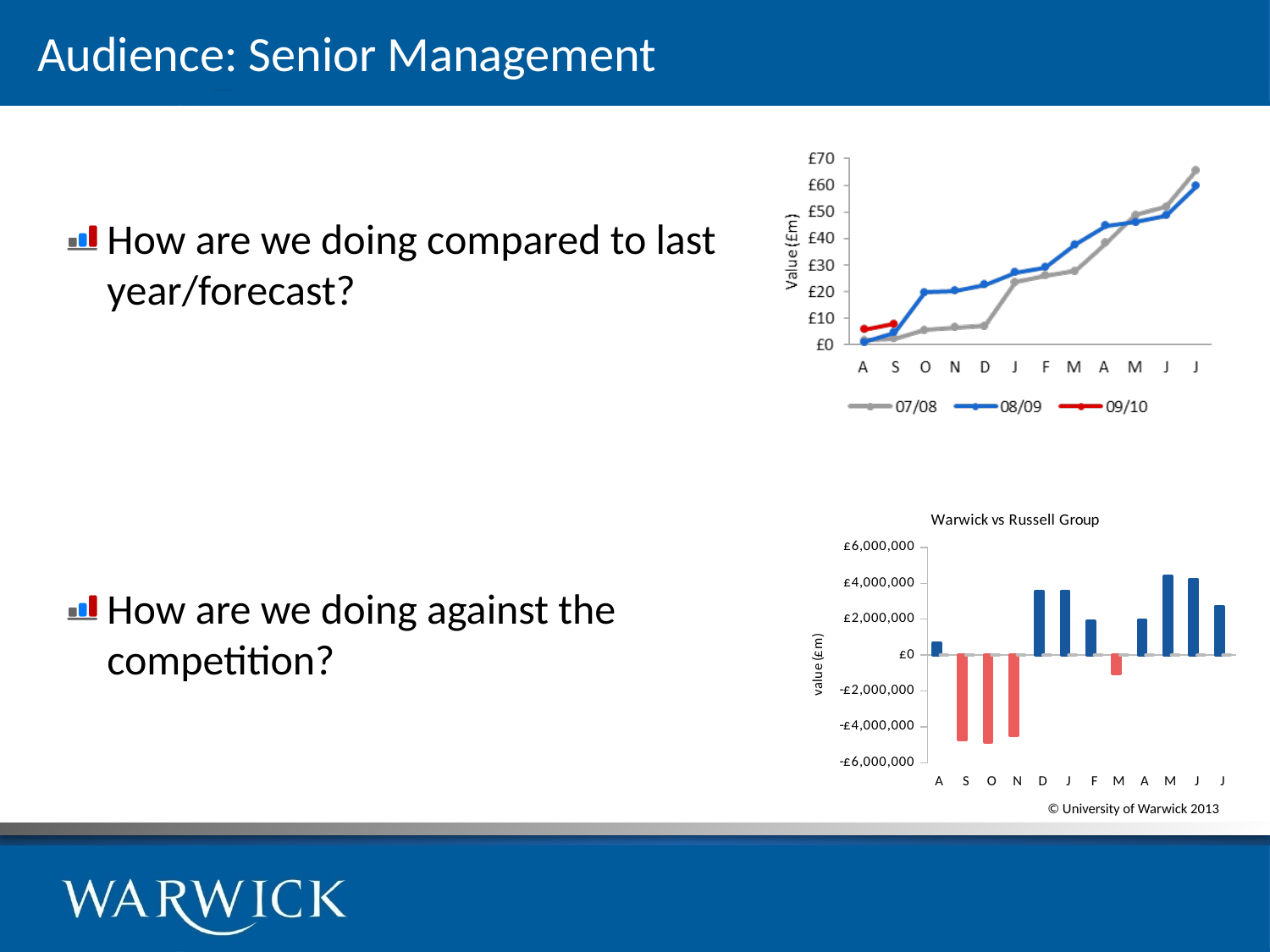
How many categories are shown on the x axis of the 'Warwick vs Russell Group' chart? 12 In the 'Warwick vs Russell Group' chart, is the value for D greater or less than £2,000,000? greater In the 'Warwick vs Russell Group' chart, is the value for S greater or less than -£4,000,000? less What are the series names in the legend of the top line chart? 07/08, 08/09, 09/10 How many series does the legend of the top line chart list? 3 In the top line chart, is the value for 07/08 in D greater or less than £10? less What kind of chart is the 'Warwick vs Russell Group' chart? bar chart What kind of chart is the top chart on the slide? line chart What is the title of the bottom chart? Warwick vs Russell Group In the top line chart, does the 08/09 series generally rise or fall from A to J? rise